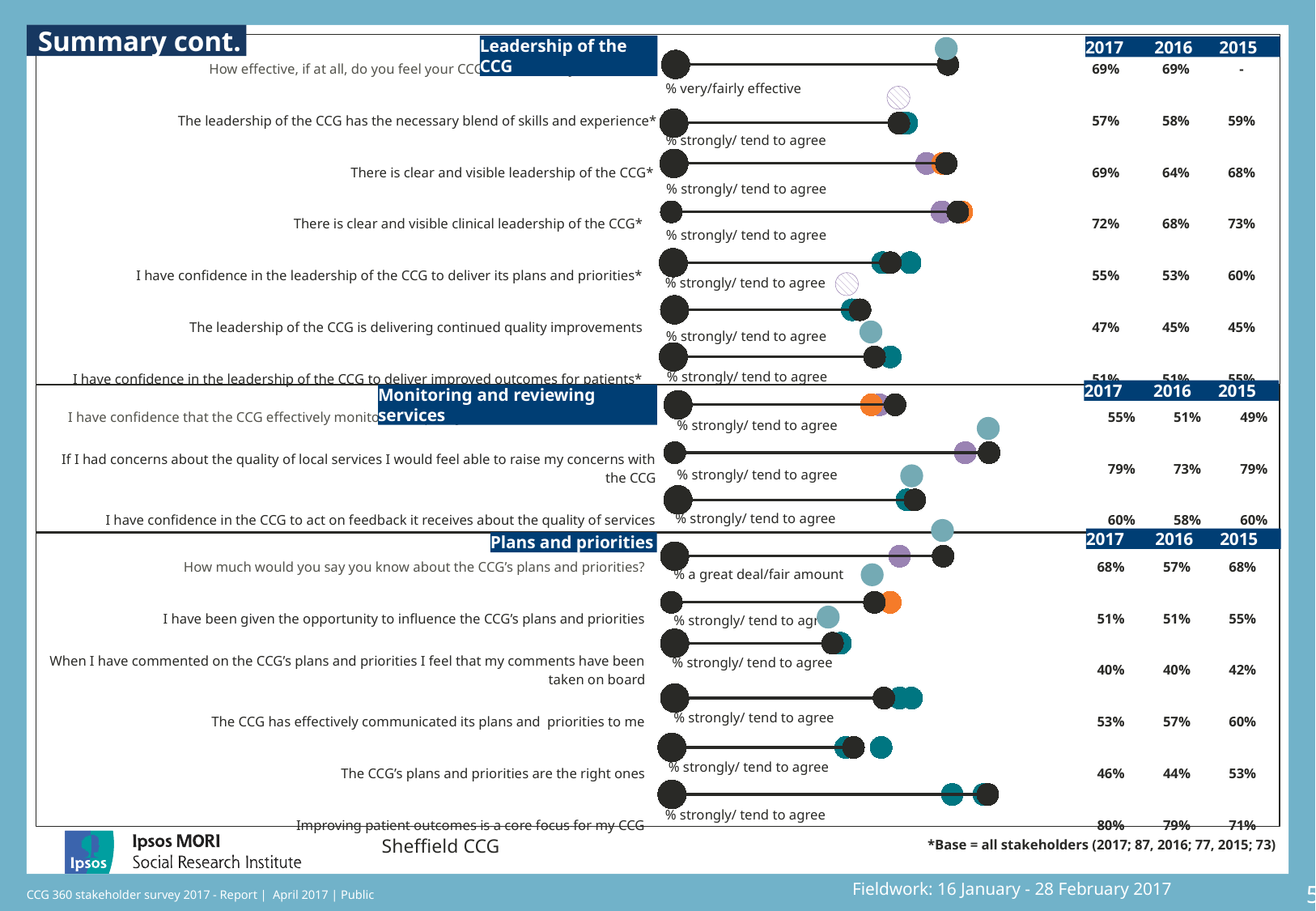
In the Plans and priorities section, which statement has the lowest 2017 value? When I have commented on the CCG's plans and priorities I feel that my comments have been taken on board In the Monitoring and reviewing services section, what is the 2015 value for 'I have confidence that the CCG effectively monitors the quality of services'? 49% In the Leadership of the CCG section, what is the 2016 value for 'The leadership of the CCG has the necessary blend of skills and experience'? 58% In the Leadership of the CCG section, what is the 2017 value for 'There is clear and visible clinical leadership of the CCG'? 72% In the Leadership of the CCG section, which statement has the lowest 2017 value? The leadership of the CCG is delivering continued quality improvements In the Monitoring and reviewing services section, what is the difference between the 2017 and 2016 values for 'If I had concerns about the quality of local services I would feel able to raise my concerns with the CCG'? 6% In the Plans and priorities section, did the value for 'The CCG has effectively communicated its plans and priorities to me' rise or fall from 2015 to 2017? fall In the Plans and priorities section, which statement has the highest 2017 value? Improving patient outcomes is a core focus for my CCG In the Plans and priorities section, is the 2017 value for 'How much would you say you know about the CCG's plans and priorities?' higher or lower than its 2016 value? higher How many statements are listed in the Monitoring and reviewing services section? 3 How many years of data are shown in the table columns for each section? 3 In the Plans and priorities section, what is the 2017 value for 'The CCG's plans and priorities are the right ones'? 46%